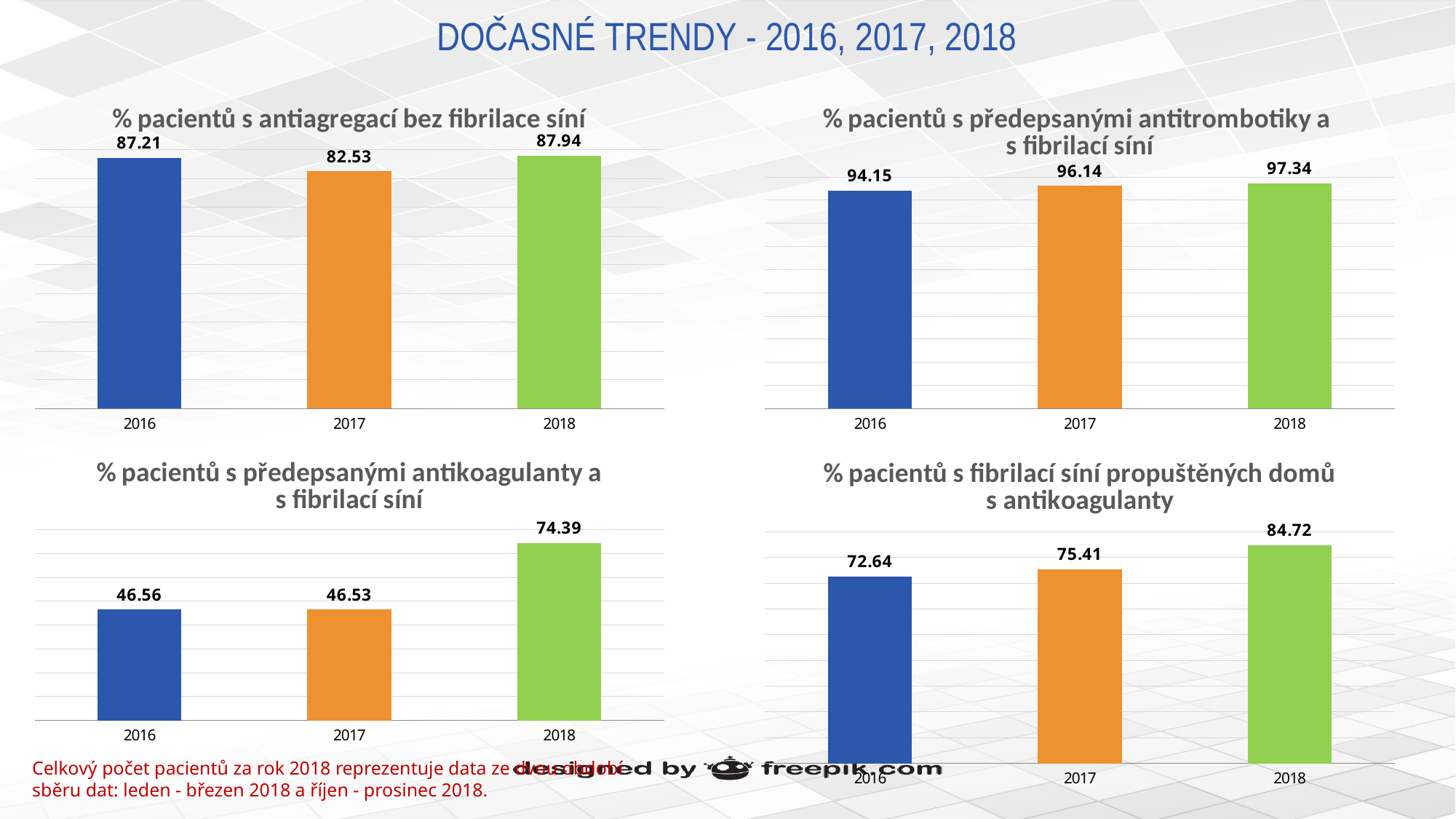
What kind of chart is the chart titled '% pacientů s antiagregací bez fibrilace síní'? bar chart In the chart titled '% pacientů s antiagregací bez fibrilace síní', which year has the lowest value? 2017 In the chart titled '% pacientů s předepsanými antitrombotiky a s fibrilací síní', do the values rise or fall from 2016 to 2018? rise In the chart titled '% pacientů s předepsanými antikoagulanty a s fibrilací síní', what is the value for 2016? 46.56 In the chart titled '% pacientů s předepsanými antikoagulanty a s fibrilací síní', which year has the highest value? 2018 In the chart titled '% pacientů s předepsanými antikoagulanty a s fibrilací síní', what is the difference between the 2018 and 2017 values? 27.86 In the chart titled '% pacientů s předepsanými antitrombotiky a s fibrilací síní', what is the value for 2018? 97.34 How many bars are plotted in the chart titled '% pacientů s fibrilací síní propuštěných domů s antikoagulanty'? 3 In the chart titled '% pacientů s fibrilací síní propuštěných domů s antikoagulanty', which is larger, the value for 2016 or 2018? 2018 In the chart titled '% pacientů s fibrilací síní propuštěných domů s antikoagulanty', what is the value for 2017? 75.41 In the chart titled '% pacientů s předepsanými antitrombotiky a s fibrilací síní', what is the difference between the 2018 and 2016 values? 3.19 In the chart titled '% pacientů s antiagregací bez fibrilace síní', what is the value for 2017? 82.53